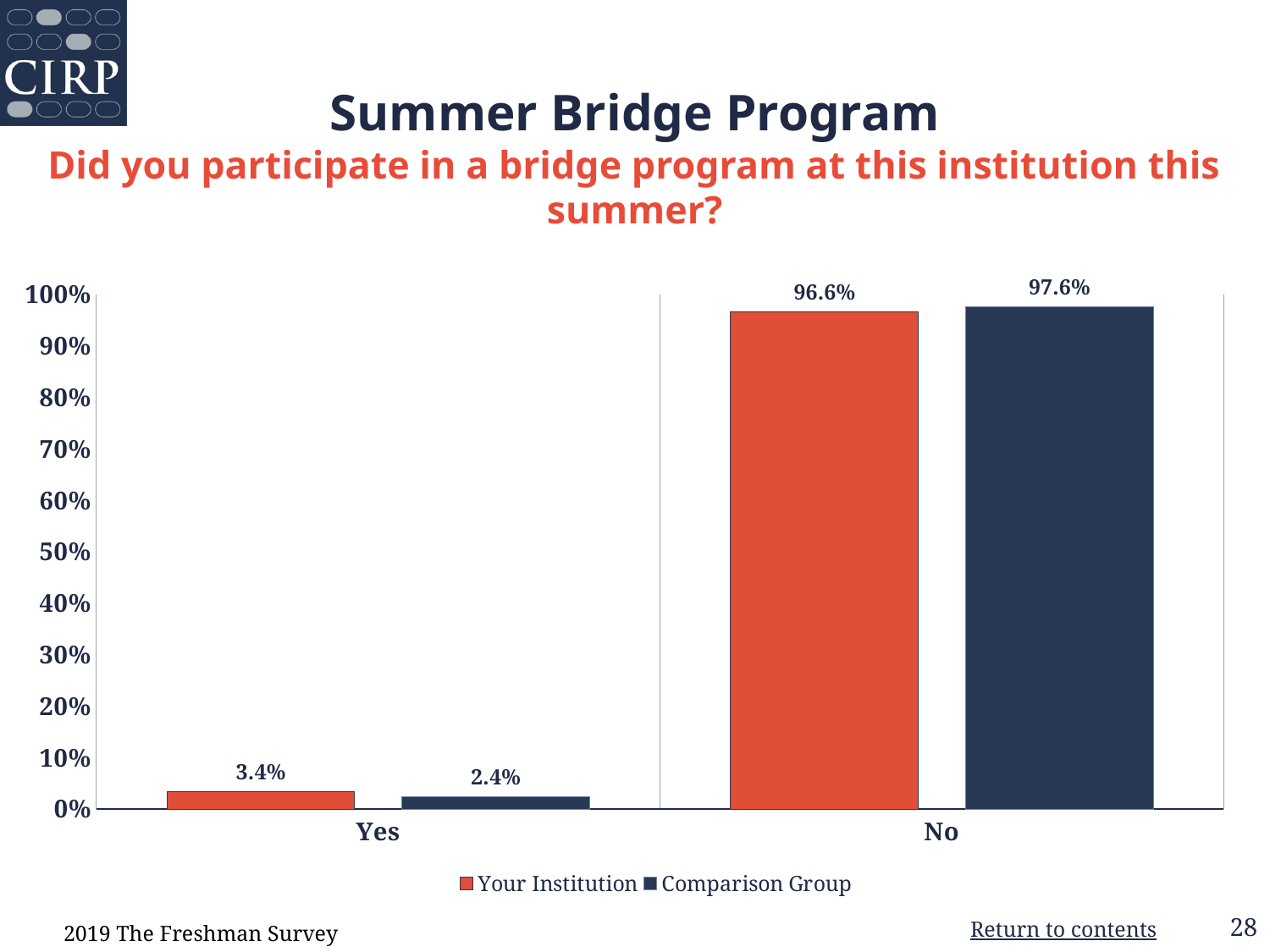
What is the difference between the Comparison Group and Your Institution for the No response? 1.0% For the Yes response, which is larger: Your Institution or the Comparison Group? Your Institution What is the difference between Your Institution and the Comparison Group for the Yes response? 1.0% What percentage of the Comparison Group answered Yes? 2.4% What percentage of the Comparison Group answered No? 97.6% What kind of chart is shown on the slide? Bar chart Which response category has the highest value for Your Institution? No What percentage of Your Institution respondents answered Yes? 3.4% How many series does the legend list? 2 Which response category has the lowest value for the Comparison Group? Yes What percentage of Your Institution respondents answered No? 96.6% Which colour represents the Comparison Group in the chart? Dark navy blue